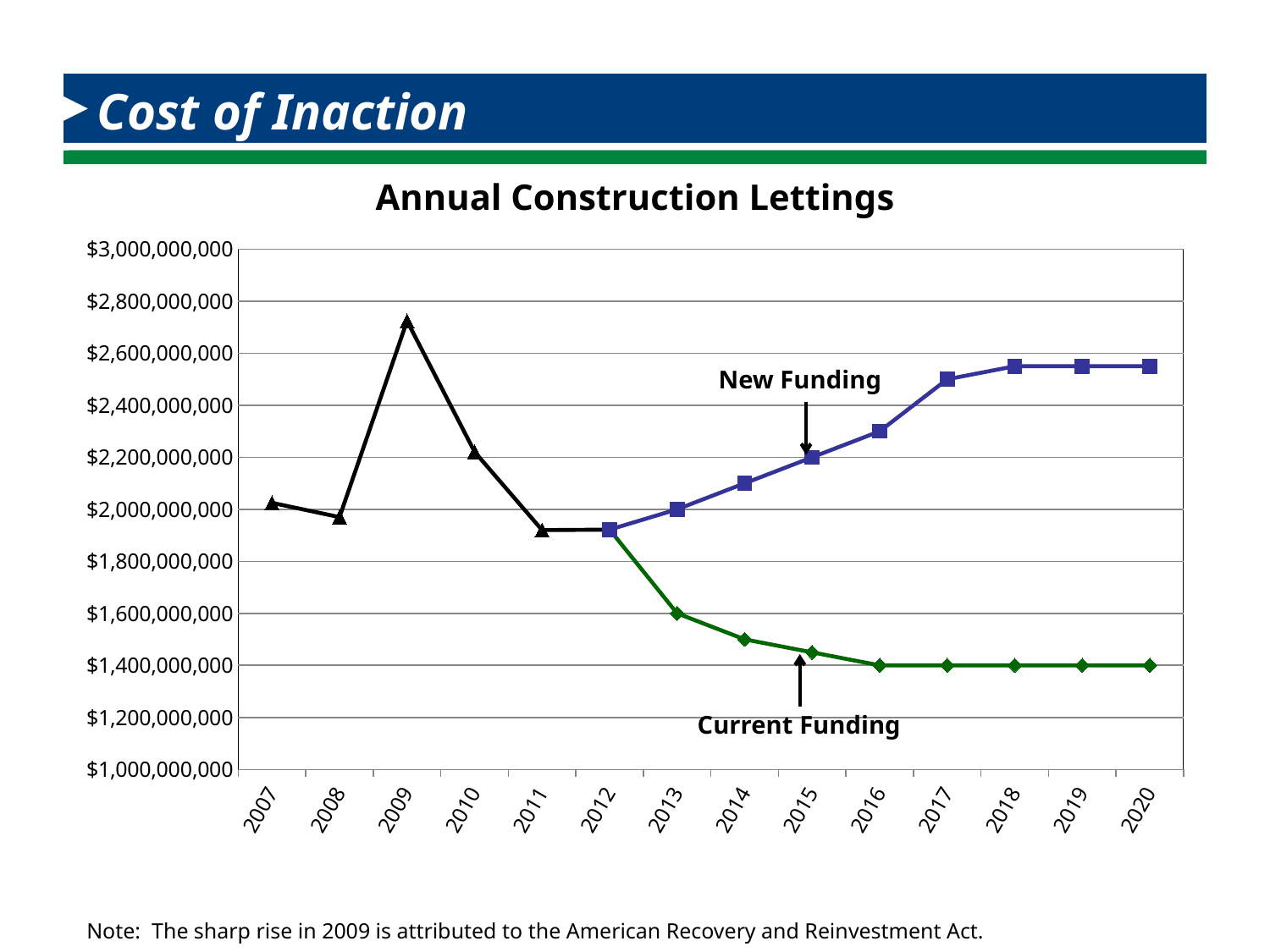
What is the Current Funding value for 2013? $1,600,000,000 What is the New Funding value for 2013? $2,000,000,000 What kind of chart is shown on the slide? line chart What is the title of the chart? Annual Construction Lettings How many years are shown on the x axis of the chart? 14 What is the difference between the New Funding and Current Funding values in 2013? $400,000,000 Is the value for 2009 greater or less than $2,600,000,000? greater In which year does the chart reach its highest value? 2009 Is the Current Funding value for 2014 greater or less than $1,600,000,000? less What is the New Funding value for 2015? $2,200,000,000 What is the Current Funding value for 2020? $1,400,000,000 Does the Current Funding line rise or fall from 2012 to 2016? fall